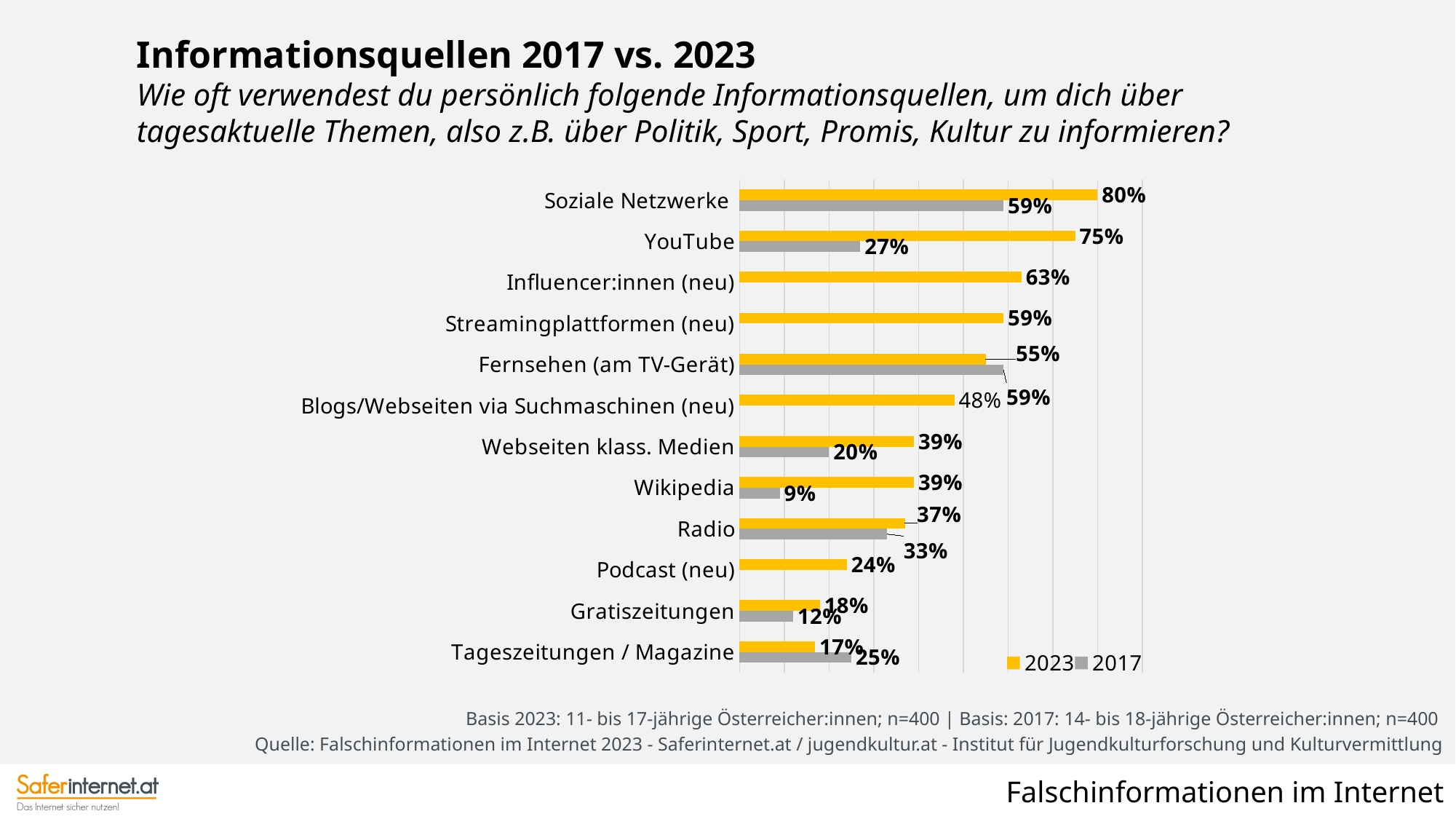
What is the 2017 value for Wikipedia? 9% What is the 2023 value for Influencer:innen (neu)? 63% What is the difference between the 2023 and 2017 values for YouTube? 48 percentage points Which information source has the lowest 2023 value? Tageszeitungen / Magazine What is the 2017 value for YouTube? 27% How many information sources are listed in the chart? 12 Which colour represents the year 2017 in the chart? Grey For Tageszeitungen / Magazine, which year has the larger value, 2023 or 2017? 2017 Which information source has the highest 2023 value? Soziale Netzwerke How many series does the legend list? 2 What kind of chart is shown on the slide? Bar chart What is the 2023 value for Soziale Netzwerke? 80%